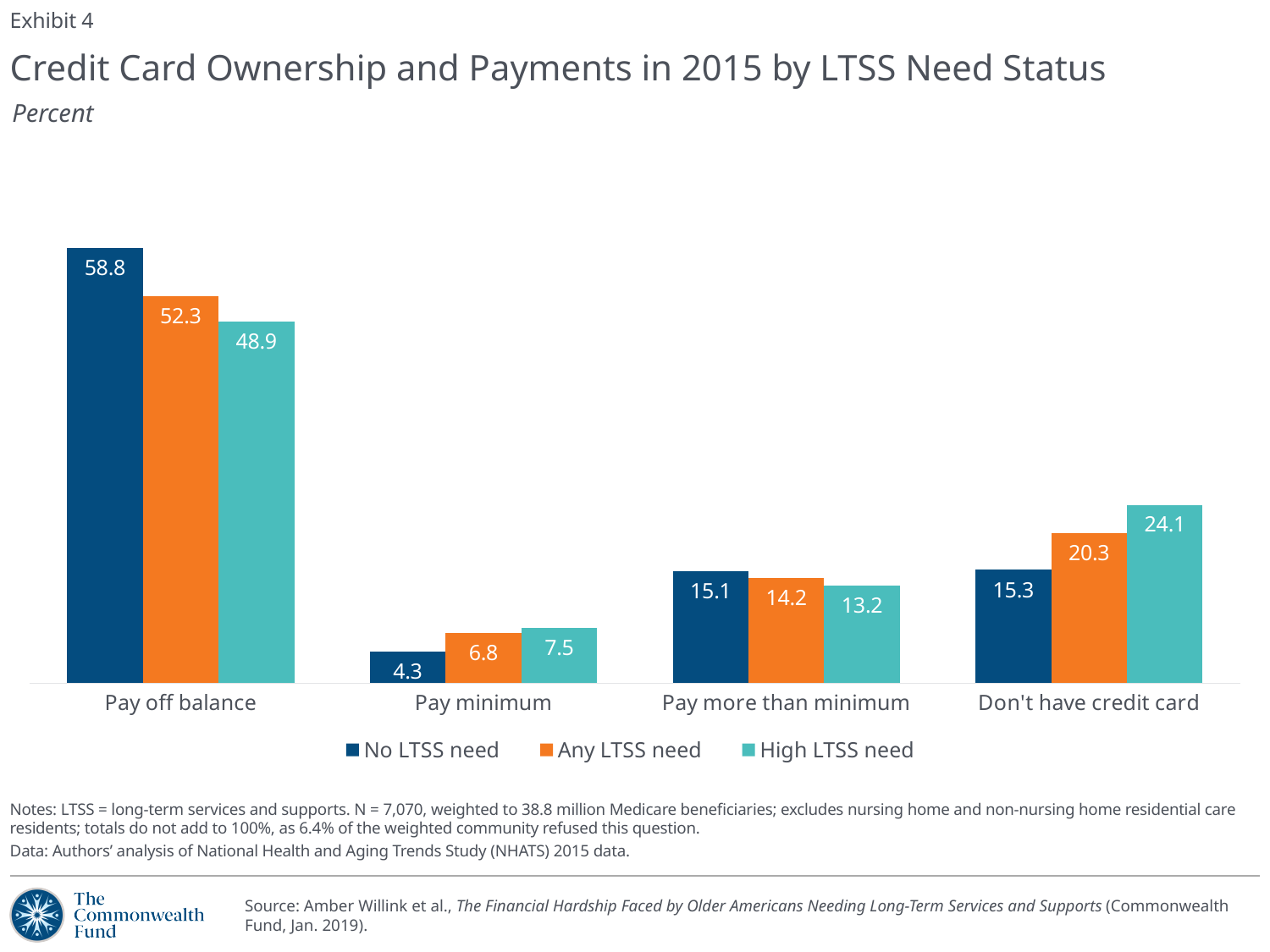
Which category has the highest value for No LTSS need? Pay off balance Which is larger in the Don't have credit card category: No LTSS need or Any LTSS need? Any LTSS need What is the value for Any LTSS need in the Pay minimum category? 6.8 What is the value for High LTSS need in the Don't have credit card category? 24.1 How many series does the legend list? 3 Which category has the lowest value for High LTSS need? Pay minimum What kind of chart is this? Bar chart How many categories are shown on the x axis? 4 Which series is shown in orange in the legend? Any LTSS need What is the difference between Any LTSS need and No LTSS need in the Pay minimum category? 2.5 What is the difference between No LTSS need and High LTSS need in the Pay off balance category? 9.9 What is the value for No LTSS need in the Pay off balance category? 58.8